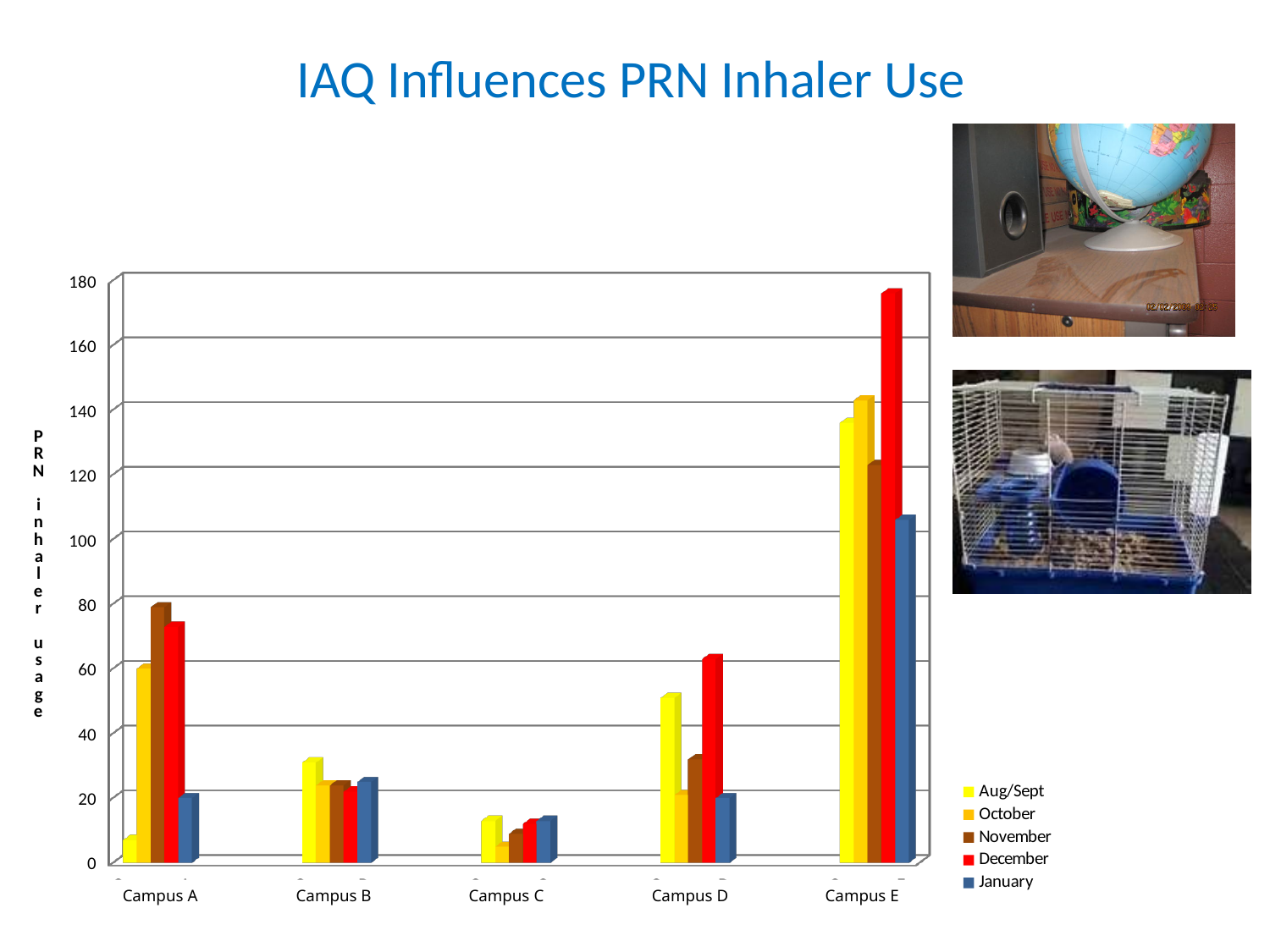
Is the December value for Campus E greater or less than 160? greater How many series does the legend list? 5 Is the January value for Campus A greater or less than 40? less Is the November value for Campus E greater or less than 100? greater Which campus has the highest December value? Campus E Which campus has the lowest October value? Campus C What is the title of the slide? IAQ Influences PRN Inhaler Use What kind of chart is shown on the slide? bar chart Which is larger for Campus A, the Aug/Sept value or the October value? October How many campuses are shown on the x axis? 5 Which is larger for Campus D, the December value or the January value? December